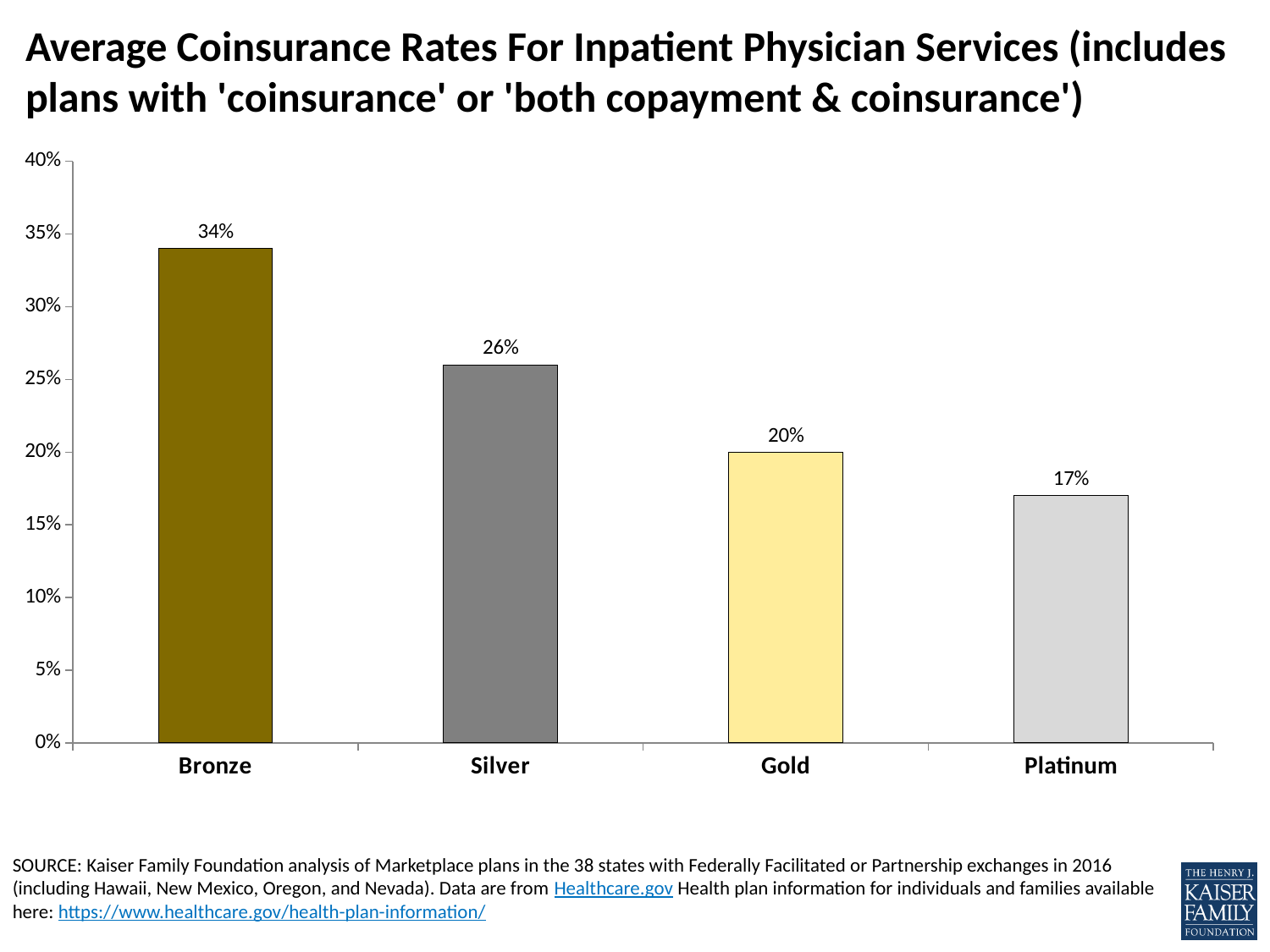
Do the average coinsurance rates rise or fall from Bronze to Platinum? Fall Which has a higher average coinsurance rate, Silver or Gold? Silver What is the average coinsurance rate for Silver plans? 26% What is the average coinsurance rate for Platinum plans? 17% What is the average coinsurance rate for Bronze plans? 34% How many plan tiers are shown in the chart? 4 What is the difference between the Gold and Platinum average coinsurance rates? 3% Which plan tier has the lowest average coinsurance rate? Platinum Which plan tier has the highest average coinsurance rate? Bronze What kind of chart is shown on the slide? Bar chart What is the difference between the Bronze and Silver average coinsurance rates? 8% What is the average coinsurance rate for Gold plans? 20%